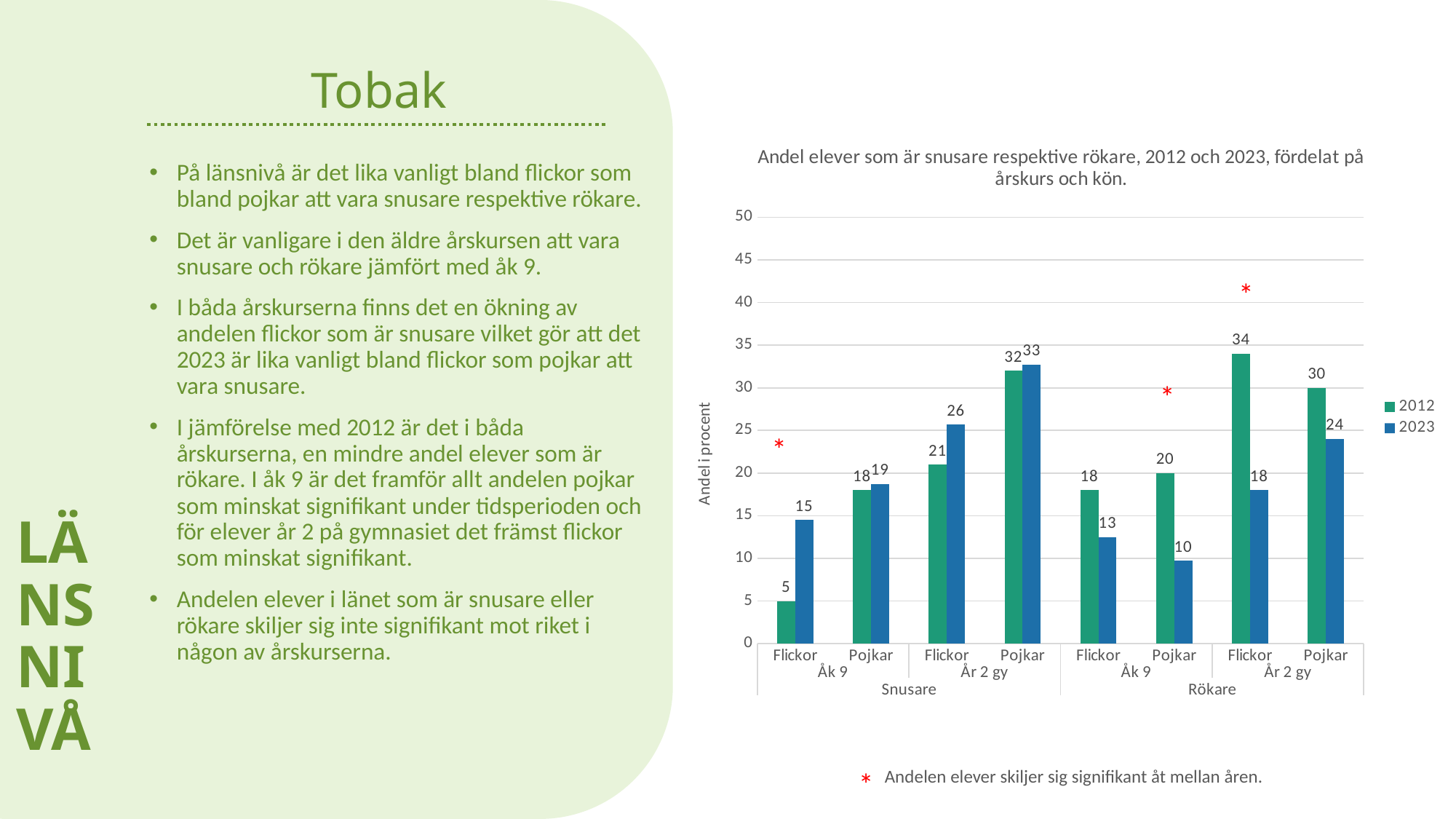
Which is larger for Pojkar in Åk 9 under Rökare: the 2012 value or the 2023 value? 2012 How many category groups (Flickor/Pojkar pairs) are shown along the x axis? 4 What kind of chart is shown on the slide? Bar chart Which bar has the lowest value in the chart? Flickor, Åk 9, Snusare, 2012 (5) What is the 2023 value for Pojkar in År 2 gy under Rökare? 24 What is the label of the y axis? Andel i procent What is the 2012 value for Flickor in Åk 9 under Snusare? 5 Which bar has the highest value in the chart? Flickor, År 2 gy, Rökare, 2012 (34) What is the 2023 value for Flickor in År 2 gy under Snusare? 26 How many series does the legend list? 2 What is the difference between the 2012 and 2023 values for Flickor in År 2 gy under Rökare? 16 What is the difference between the 2023 and 2012 values for Flickor in Åk 9 under Snusare? 10